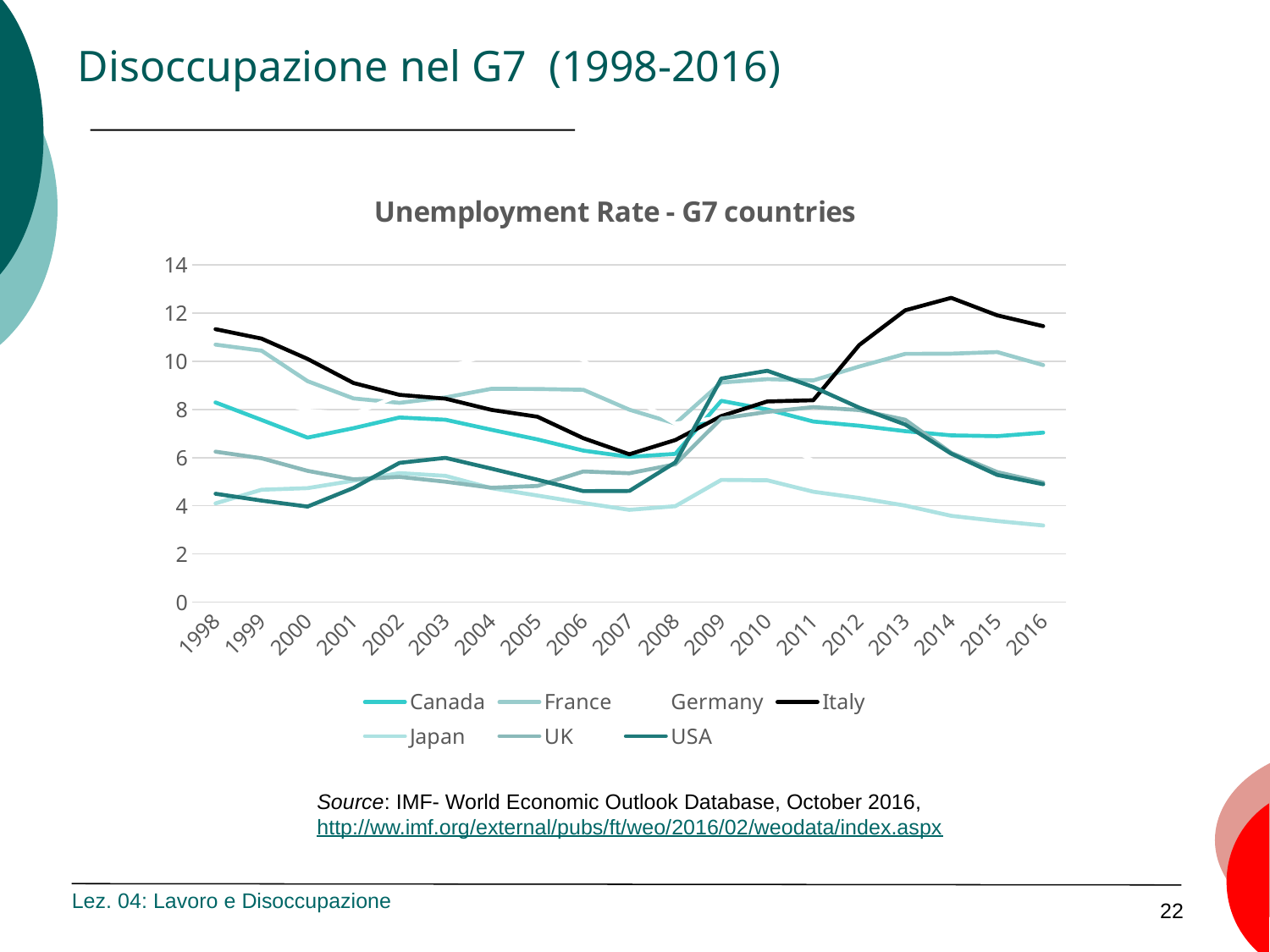
Which country has the lowest unemployment rate in 2016? Japan Is the value for USA in 2010 greater or less than 8? greater Does the unemployment rate for Italy rise or fall between 2007 and 2014? Rise Which country has the highest unemployment rate in 2016? Italy What is the title of the chart? Unemployment Rate - G7 countries Is the value for Italy in 2014 greater or less than 12? greater How many series does the legend of the chart list? 7 Which country's line is drawn in black in the chart? Italy In 2010, which is larger, the unemployment rate of France or of the UK? France What kind of chart is shown on the slide? Line chart Is the value for Japan in 2016 greater or less than 4? less How many years are plotted along the x axis of the chart? 19